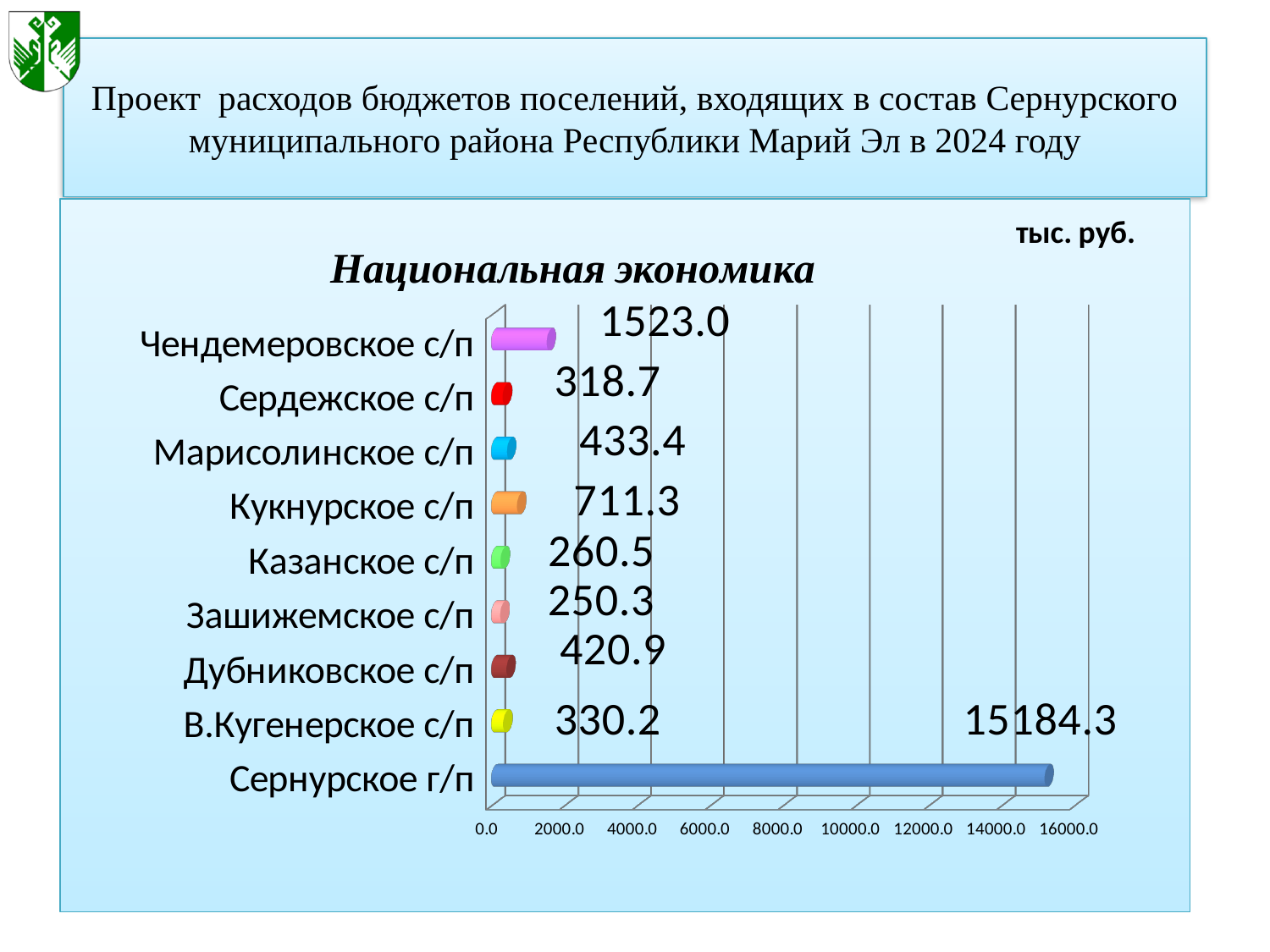
What type of chart is shown on the slide? bar chart How many settlements are shown in the chart? 9 What is the value for Чендемеровское с/п? 1523.0 What is the difference between the values for Чендемеровское с/п and Кукнурское с/п? 811.7 Is the value for Сернурское г/п greater or less than 14000.0? greater What is the value for Кукнурское с/п? 711.3 What is the value for Зашижемское с/п? 250.3 Which settlement has the highest value in the chart? Сернурское г/п Which settlement has the lowest value in the chart? Зашижемское с/п What is the value for Сернурское г/п in the Национальная экономика chart? 15184.3 Which is larger, the value for Марисолинское с/п or the value for Дубниковское с/п? Марисолинское с/п What is the title of the chart? Национальная экономика